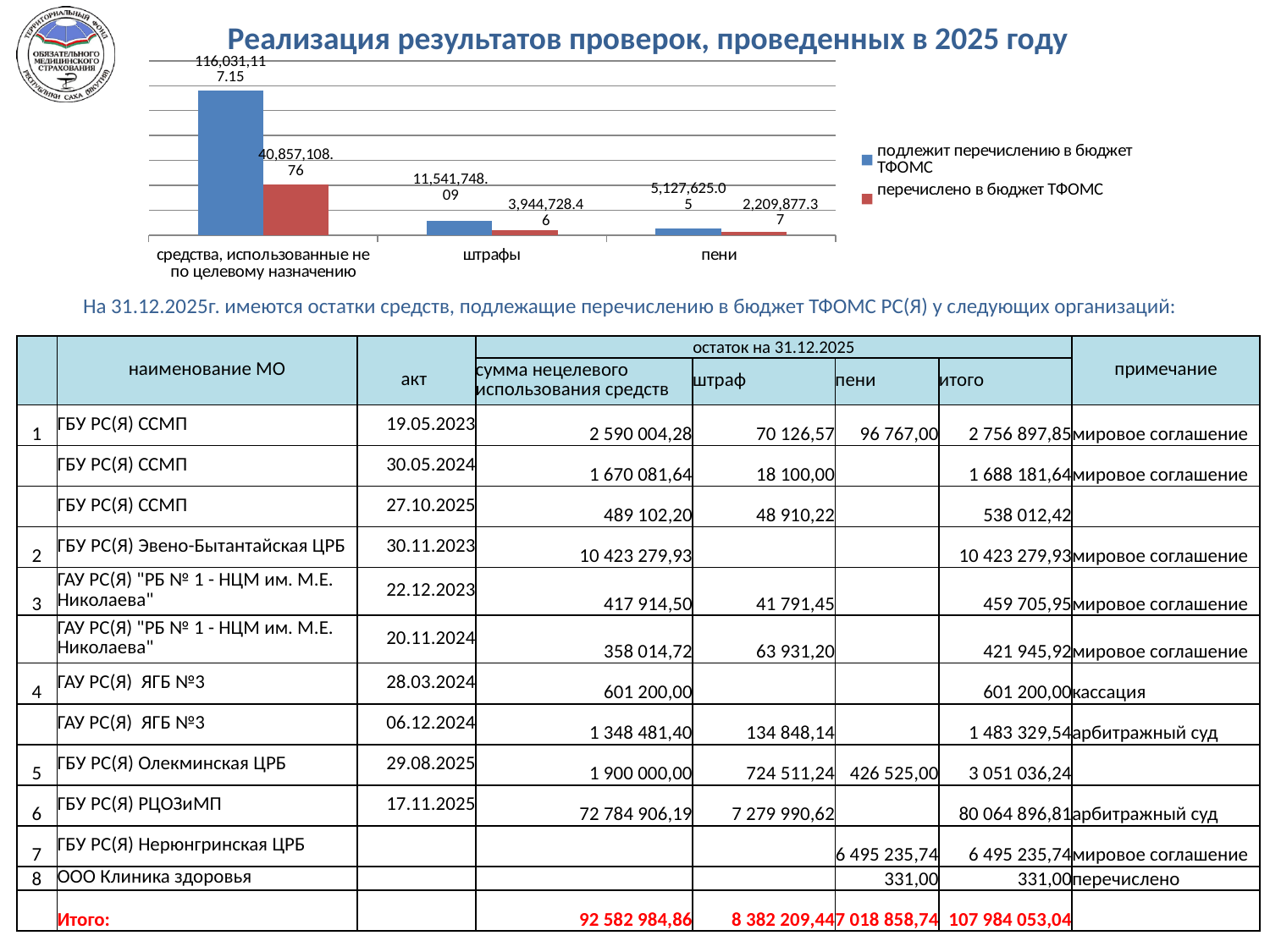
Which category has the highest value for "подлежит перечислению в бюджет ТФОМС"? средства, использованные не по целевому назначению For the series "подлежит перечислению в бюджет ТФОМС", which is larger: "штрафы" or "пени"? штрафы For "пени", what is the difference between "подлежит перечислению в бюджет ТФОМС" and "перечислено в бюджет ТФОМС"? 2,917,747.68 How many series does the chart legend list? 2 What is the value of "подлежит перечислению в бюджет ТФОМС" for "пени"? 5,127,625.05 What is the value of "перечислено в бюджет ТФОМС" for "штрафы"? 3,944,728.46 What is the value of "перечислено в бюджет ТФОМС" for "средства, использованные не по целевому назначению"? 40,857,108.76 What kind of chart is shown on the slide? bar chart What is the value of "подлежит перечислению в бюджет ТФОМС" for "средства, использованные не по целевому назначению"? 116,031,117.15 Which category has the lowest value for "перечислено в бюджет ТФОМС"? пени How many categories are shown on the x axis of the chart? 3 Do the values of "подлежит перечислению в бюджет ТФОМС" rise or fall from left to right along the x axis? fall